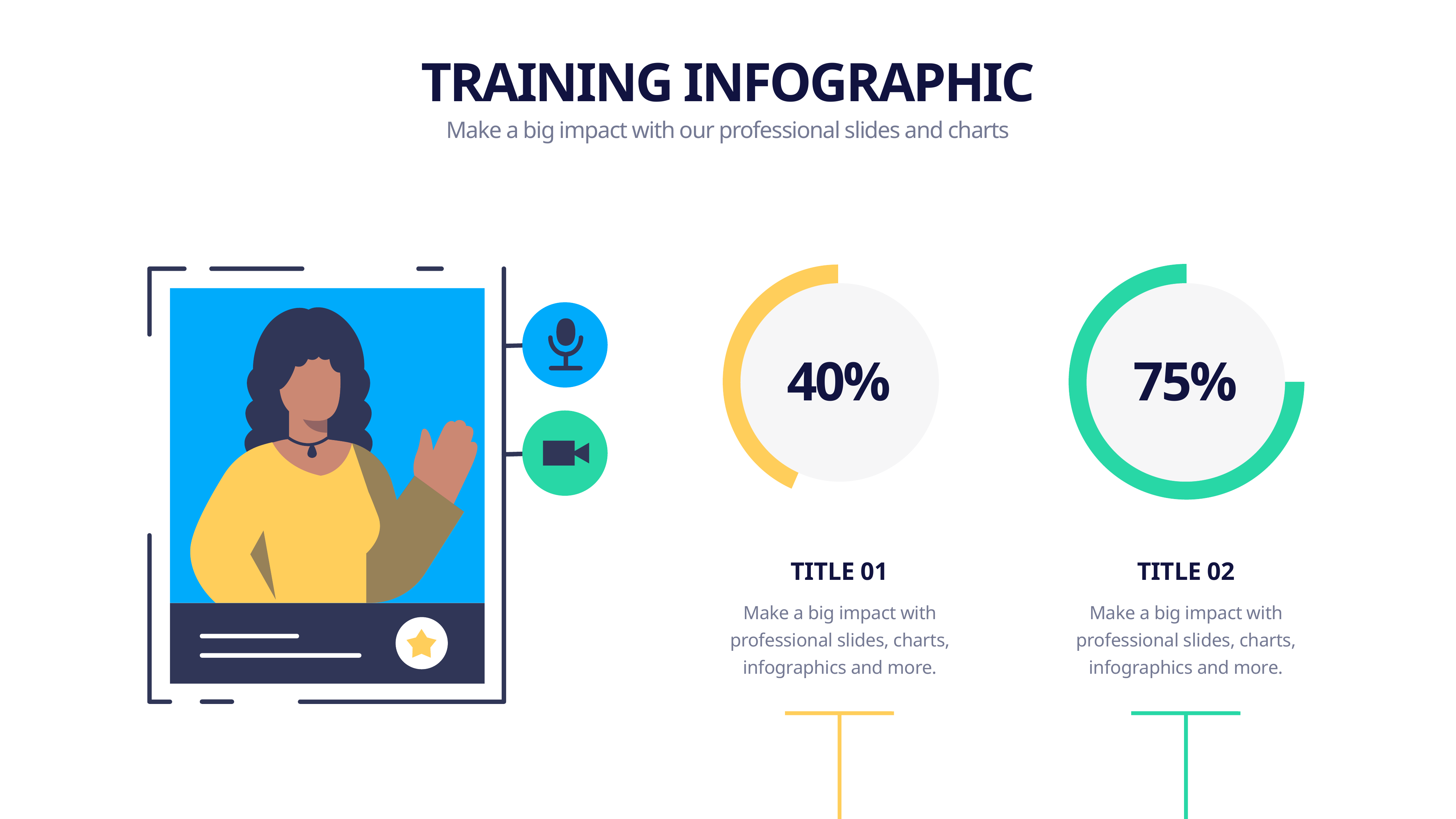
Is the value shown in the TITLE 01 ring chart greater or less than 50%? less Which of the two ring charts shows the higher percentage, TITLE 01 or TITLE 02? TITLE 02 Is the value shown in the TITLE 02 ring chart greater or less than 50%? greater What percentage is shown in the ring chart labelled TITLE 01? 40% Which of the two ring charts shows the lower percentage, TITLE 01 or TITLE 02? TITLE 01 What colour is the filled arc of the ring chart labelled TITLE 01? Yellow What kind of chart is used to display the 40% and 75% values? Ring (donut) progress chart How many ring charts are shown on the slide? 2 What percentage is shown in the ring chart labelled TITLE 02? 75% What is the difference in percentage points between the TITLE 02 ring chart and the TITLE 01 ring chart? 35 What colour is the filled arc of the ring chart labelled TITLE 02? Green